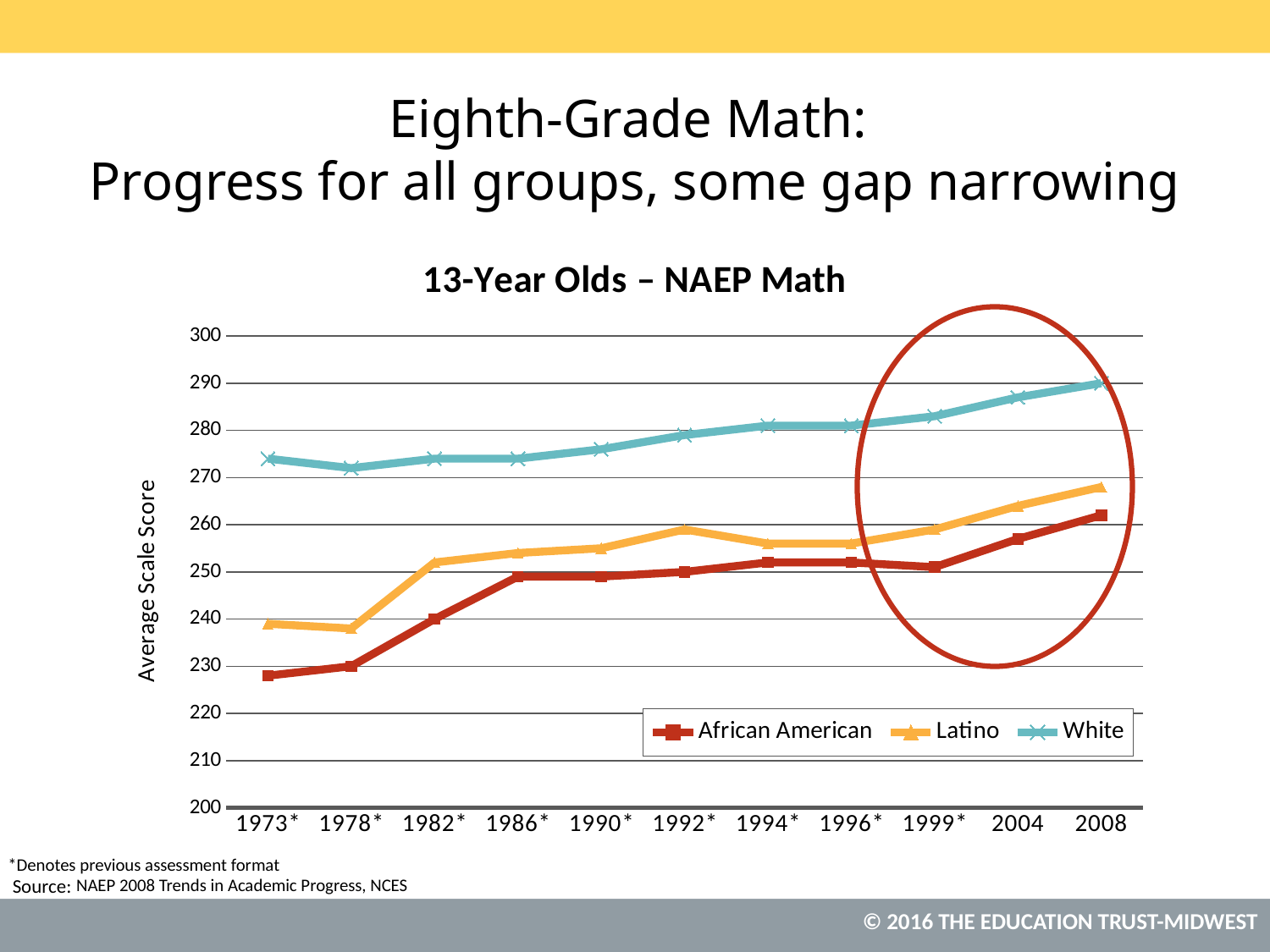
Which group has the lowest average scale score in 1973*? African American Which group has the highest average scale score in 2008? White What is the title of the chart? 13-Year Olds – NAEP Math How many series does the legend list? 3 In 1986*, which group scored higher, Latino or African American? Latino What is the title of the y axis? Average Scale Score Is the value for Latino in 2008 greater or less than 270? less How many assessment years are plotted along the x axis? 11 Is the value for White in 1973* greater or less than 270? greater Is the value for African American in 1973* greater or less than 230? less What kind of chart is shown on the slide? line chart Does the White line rise or fall from 1999* to 2008? rises